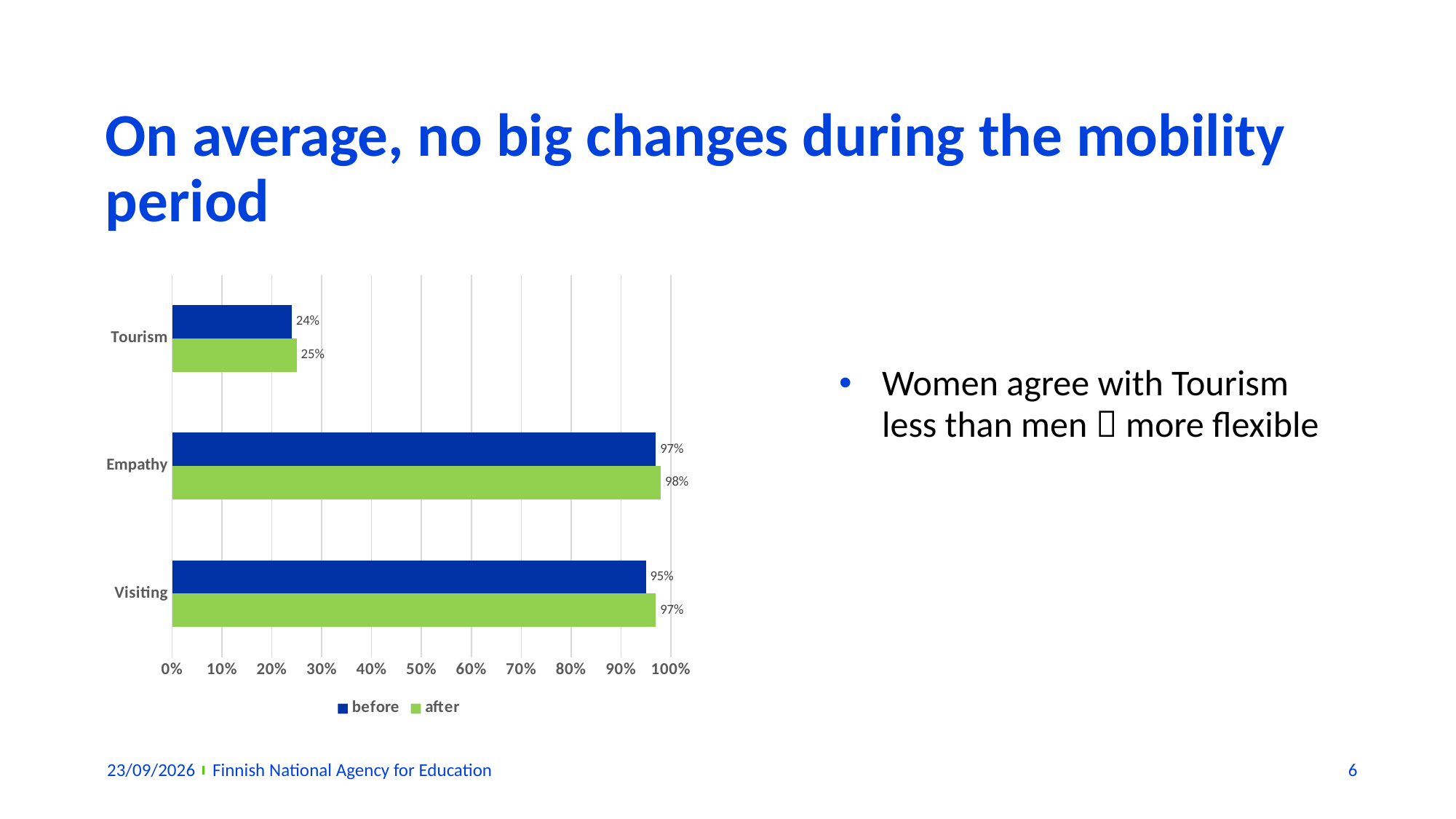
How many series does the legend list? 2 What is the difference between the 'after' and 'before' values for Visiting? 2% What is the 'before' value for Tourism? 24% What kind of chart is shown on the slide? bar chart Which colour represents the 'after' series in the chart? green Is the 'before' value for Empathy greater or less than 90%? greater What is the 'before' value for Visiting? 95% What is the 'after' value for Tourism? 25% What is the 'after' value for Empathy? 98% Which category has the lowest 'before' value? Tourism Which category has the highest 'after' value? Empathy How many categories are shown on the chart? 3